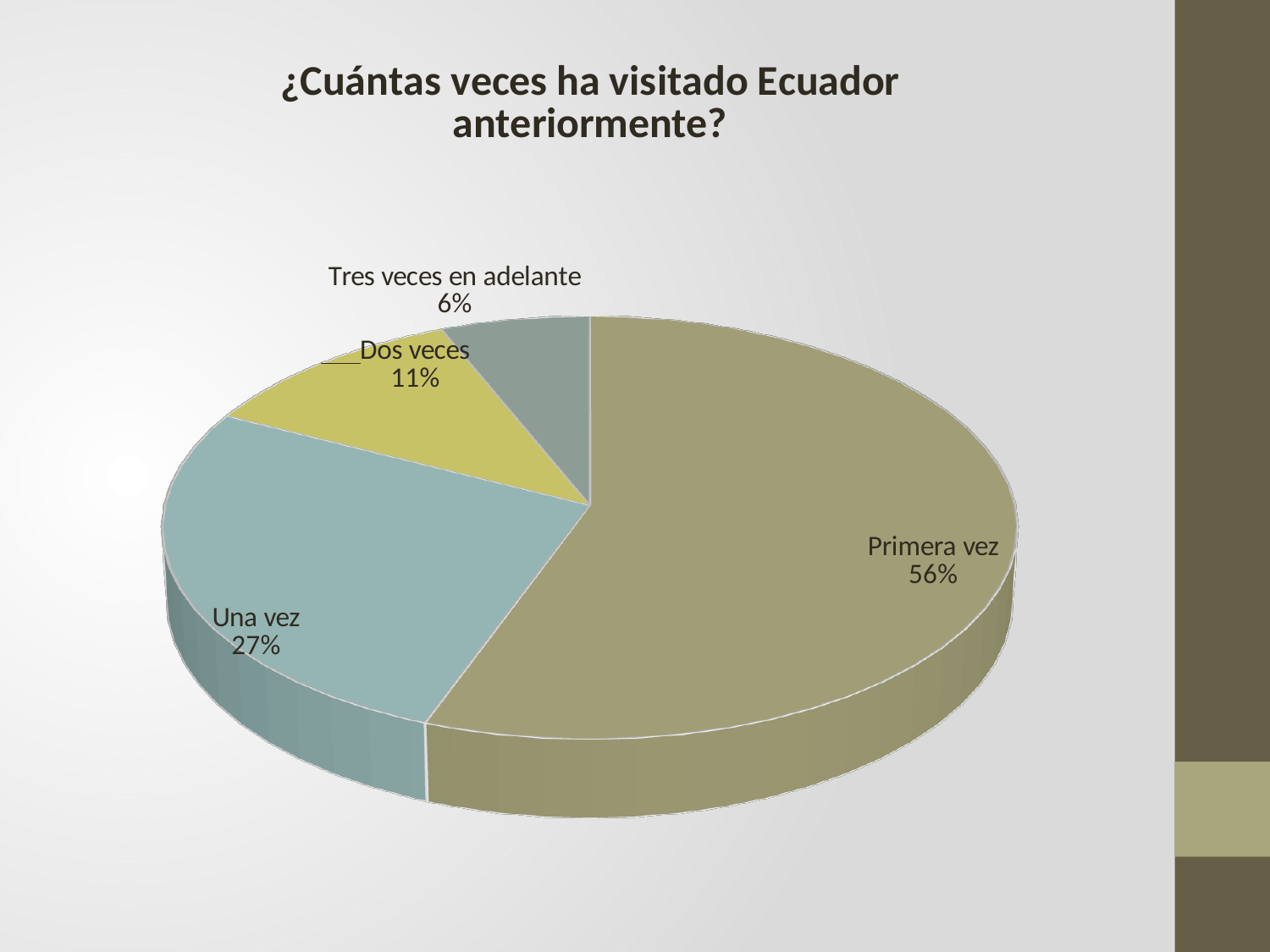
Which category has the smallest slice of the pie? Tres veces en adelante What kind of chart is shown on the slide? Pie chart What is the value shown for "Dos veces"? 11% What is the difference in percentage points between "Dos veces" and "Tres veces en adelante"? 5 What share of the pie does "Primera vez" represent? 56% What is the difference in percentage points between "Primera vez" and "Una vez"? 29 How many categories are shown in the pie chart? 4 Which category has the largest slice of the pie? Primera vez What is the title of the chart? ¿Cuántas veces ha visitado Ecuador anteriormente? Which is larger, the slice for "Una vez" or the slice for "Dos veces"? Una vez What is the value shown for "Una vez"? 27% What is the value shown for "Tres veces en adelante"? 6%